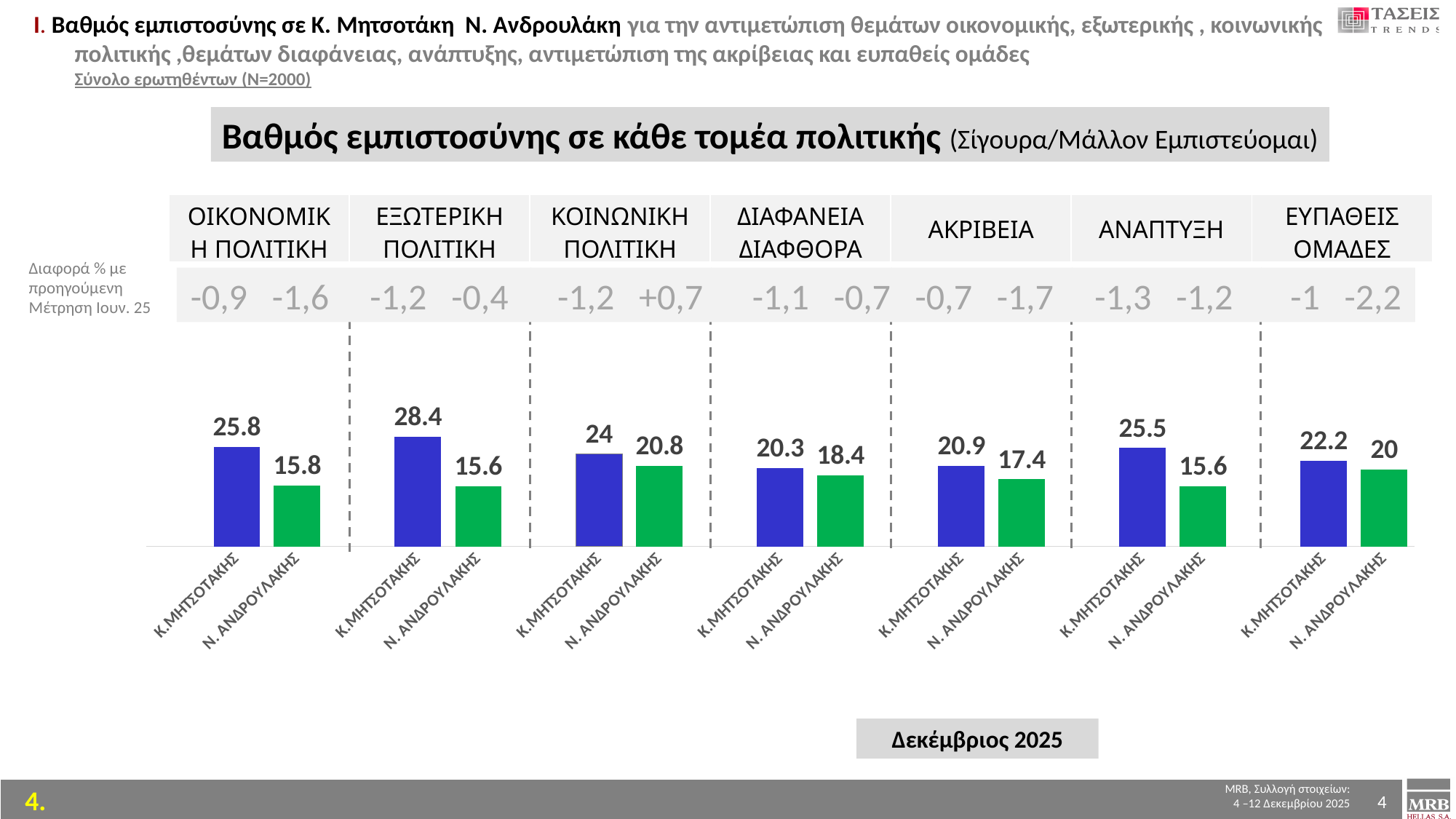
What is the value for Ν. ΑΝΔΡΟΥΛΑΚΗΣ in the ΕΥΠΑΘΕΙΣ ΟΜΑΔΕΣ section? 20 What kind of chart is shown on the slide? Bar chart In which policy area does Κ. ΜΗΤΣΟΤΑΚΗΣ have the lowest value? ΔΙΑΦΑΝΕΙΑ ΔΙΑΦΘΟΡΑ What is the difference between Κ. ΜΗΤΣΟΤΑΚΗΣ and Ν. ΑΝΔΡΟΥΛΑΚΗΣ in the ΑΝΑΠΤΥΞΗ section? 9.9 What is the difference between Κ. ΜΗΤΣΟΤΑΚΗΣ and Ν. ΑΝΔΡΟΥΛΑΚΗΣ in the ΟΙΚΟΝΟΜΙΚΗ ΠΟΛΙΤΙΚΗ section? 10 In the ΑΚΡΙΒΕΙΑ section, who has the larger value, Κ. ΜΗΤΣΟΤΑΚΗΣ or Ν. ΑΝΔΡΟΥΛΑΚΗΣ? Κ. ΜΗΤΣΟΤΑΚΗΣ In which policy area does Ν. ΑΝΔΡΟΥΛΑΚΗΣ have the highest value? ΚΟΙΝΩΝΙΚΗ ΠΟΛΙΤΙΚΗ In which policy area does Κ. ΜΗΤΣΟΤΑΚΗΣ have the highest value? ΕΞΩΤΕΡΙΚΗ ΠΟΛΙΤΙΚΗ What is the value for Κ. ΜΗΤΣΟΤΑΚΗΣ in the ΕΞΩΤΕΡΙΚΗ ΠΟΛΙΤΙΚΗ section? 28.4 How many policy areas are shown in the chart? 7 What colour are the bars for Κ. ΜΗΤΣΟΤΑΚΗΣ? Blue What is the value for Ν. ΑΝΔΡΟΥΛΑΚΗΣ in the ΚΟΙΝΩΝΙΚΗ ΠΟΛΙΤΙΚΗ section? 20.8